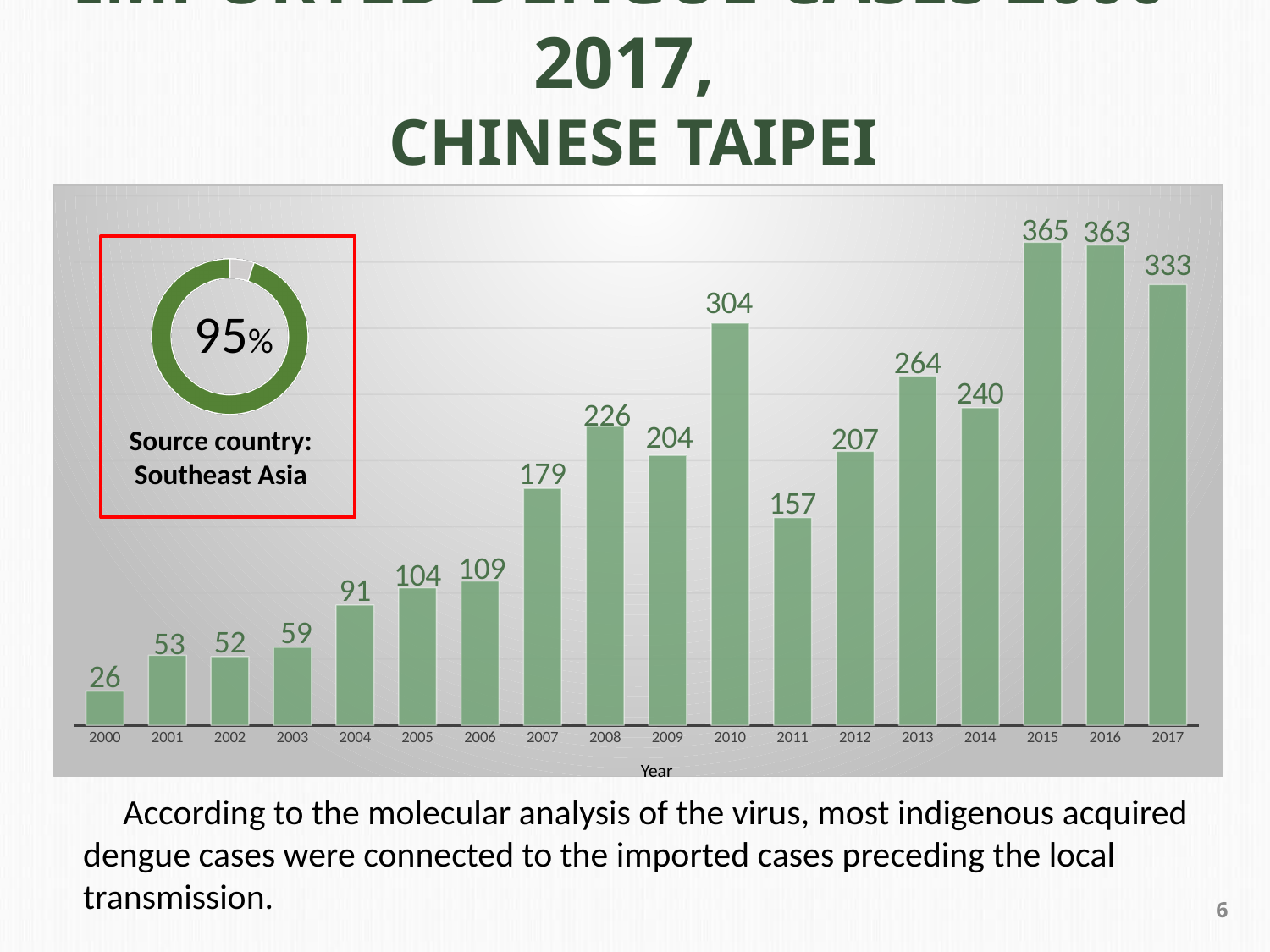
In the bar chart, what is the difference between the values for 2015 and 2017? 32 In the bar chart, do the values generally rise or fall from 2000 to 2008? Rise In the donut chart in the red box, what percentage is shown for the source country Southeast Asia? 95% What kind of chart is the large chart showing values by year? Bar chart In the bar chart, what is the value for 2000? 26 In the bar chart, which is larger, the value for 2008 or the value for 2009? 2008 In the bar chart, which year has the highest value? 2015 How many years are shown on the x axis of the bar chart? 18 In the bar chart, which year has the lowest value? 2000 In the bar chart, what is the value for 2017? 333 In the bar chart, what is the difference between the values for 2010 and 2011? 147 In the bar chart, what is the value for 2010? 304